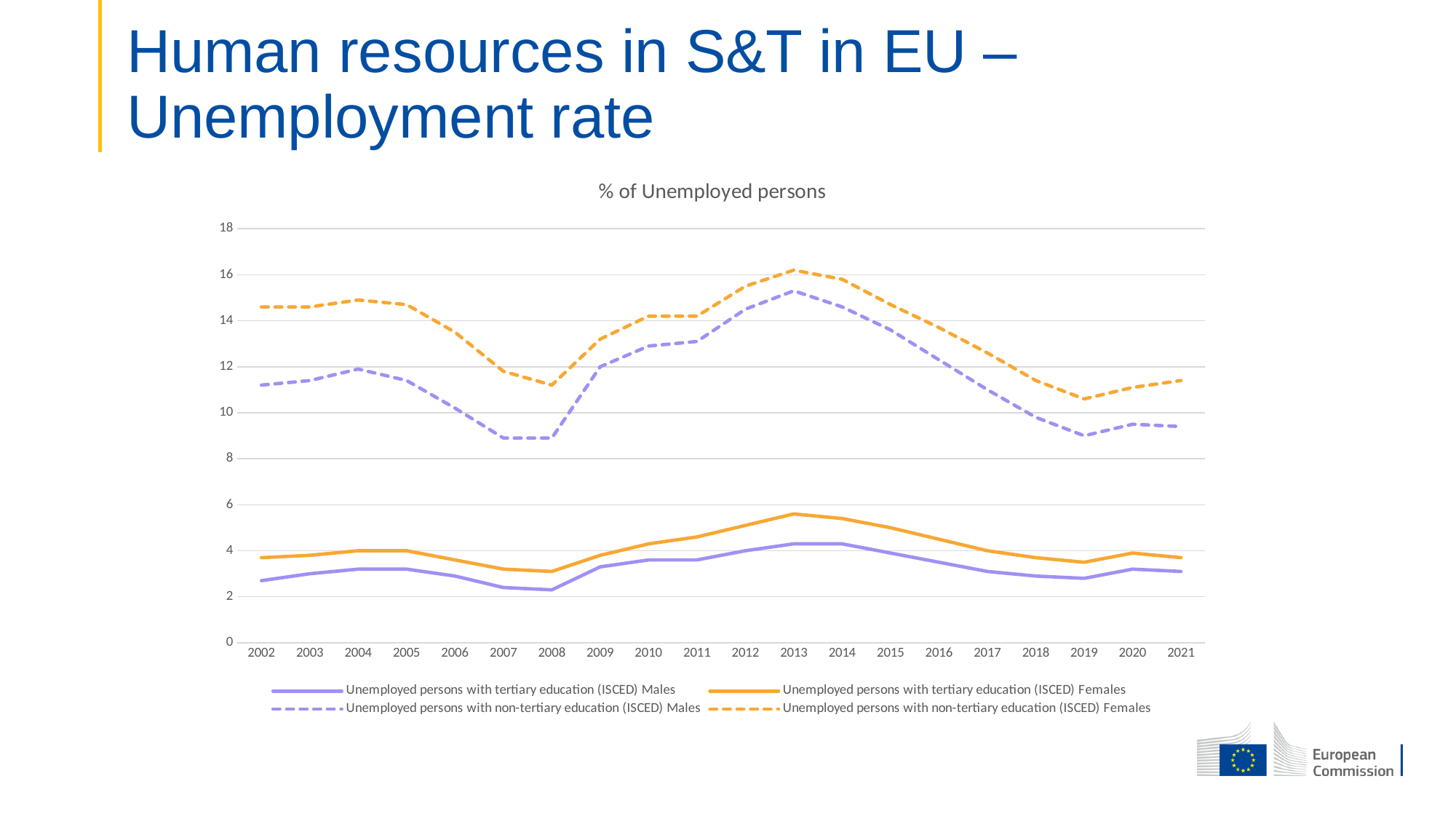
How many years are shown on the x axis? 20 What is the title of the chart? % of Unemployed persons Which series is drawn as a dashed orange line? Unemployed persons with non-tertiary education (ISCED) Females Is the value for 'Unemployed persons with tertiary education (ISCED) Females' in 2013 greater or less than 6? less What kind of chart is shown on the slide? line chart In 2013, which is higher: 'Unemployed persons with non-tertiary education (ISCED) Females' or 'Unemployed persons with non-tertiary education (ISCED) Males'? Unemployed persons with non-tertiary education (ISCED) Females Is the value for 'Unemployed persons with non-tertiary education (ISCED) Females' in 2002 greater or less than 14? greater Does the series 'Unemployed persons with tertiary education (ISCED) Females' rise or fall between 2013 and 2019? fall In which year does the series 'Unemployed persons with non-tertiary education (ISCED) Males' reach its highest value? 2013 How many series does the legend list? 4 Is the value for 'Unemployed persons with non-tertiary education (ISCED) Males' in 2007 greater or less than 10? less In which year does the series 'Unemployed persons with non-tertiary education (ISCED) Females' reach its highest value? 2013